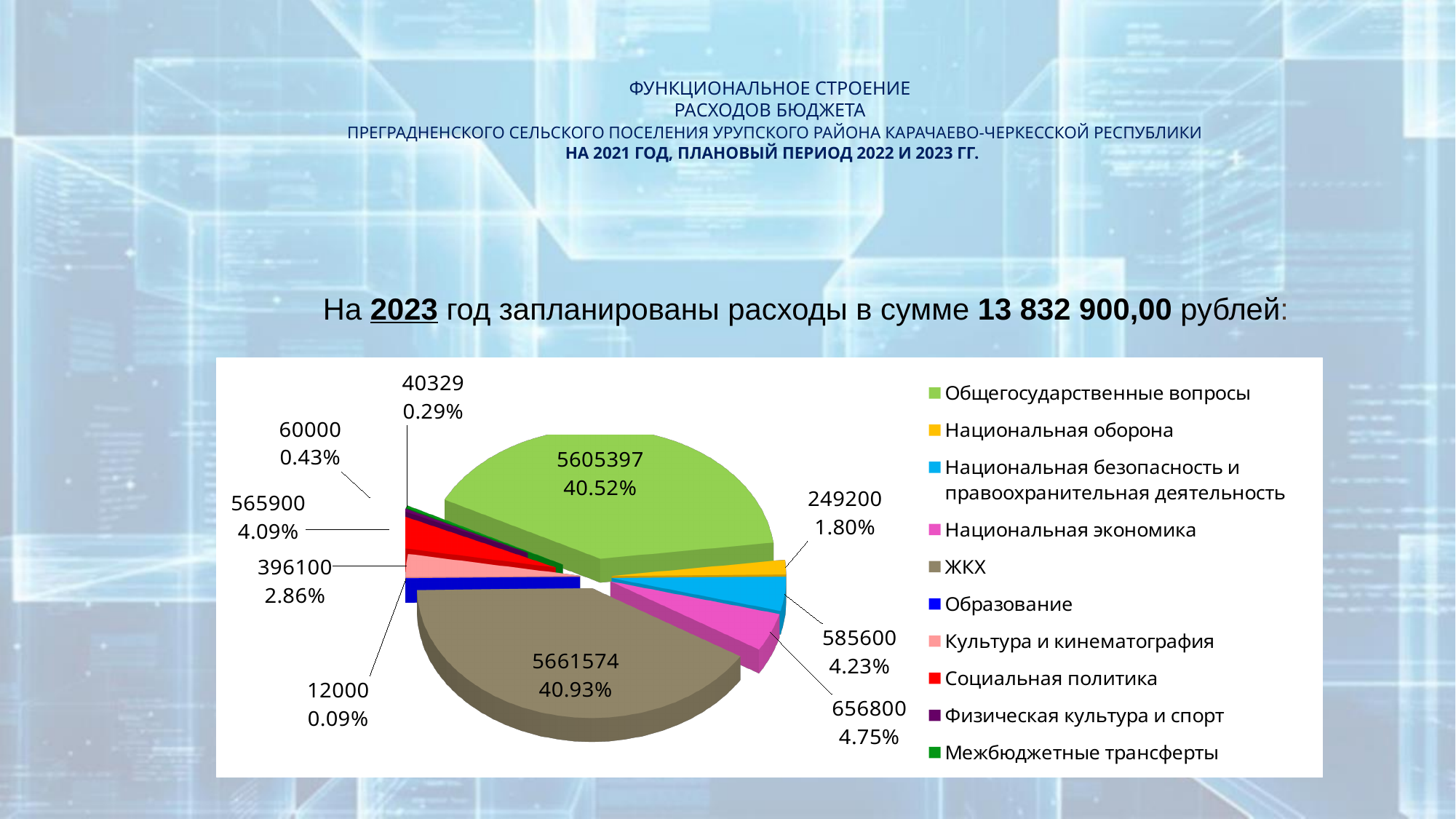
What share of the pie does Национальная оборона take? 1.80% Which category has the smallest slice in the pie chart? Образование What is the difference between the values for ЖКХ and Общегосударственные вопросы? 56177 What is the value for Национальная экономика in the pie chart? 656800 Which category has the largest slice in the pie chart? ЖКХ How many categories does the legend of the pie chart list? 10 Which is larger: Национальная экономика or Национальная безопасность и правоохранительная деятельность? Национальная экономика What kind of chart is shown on the slide? pie chart What is the value for Культура и кинематография in the pie chart? 396100 What share of the pie does Социальная политика take? 4.09% What is the value for ЖКХ in the pie chart? 5661574 What share of the pie does Общегосударственные вопросы take? 40.52%